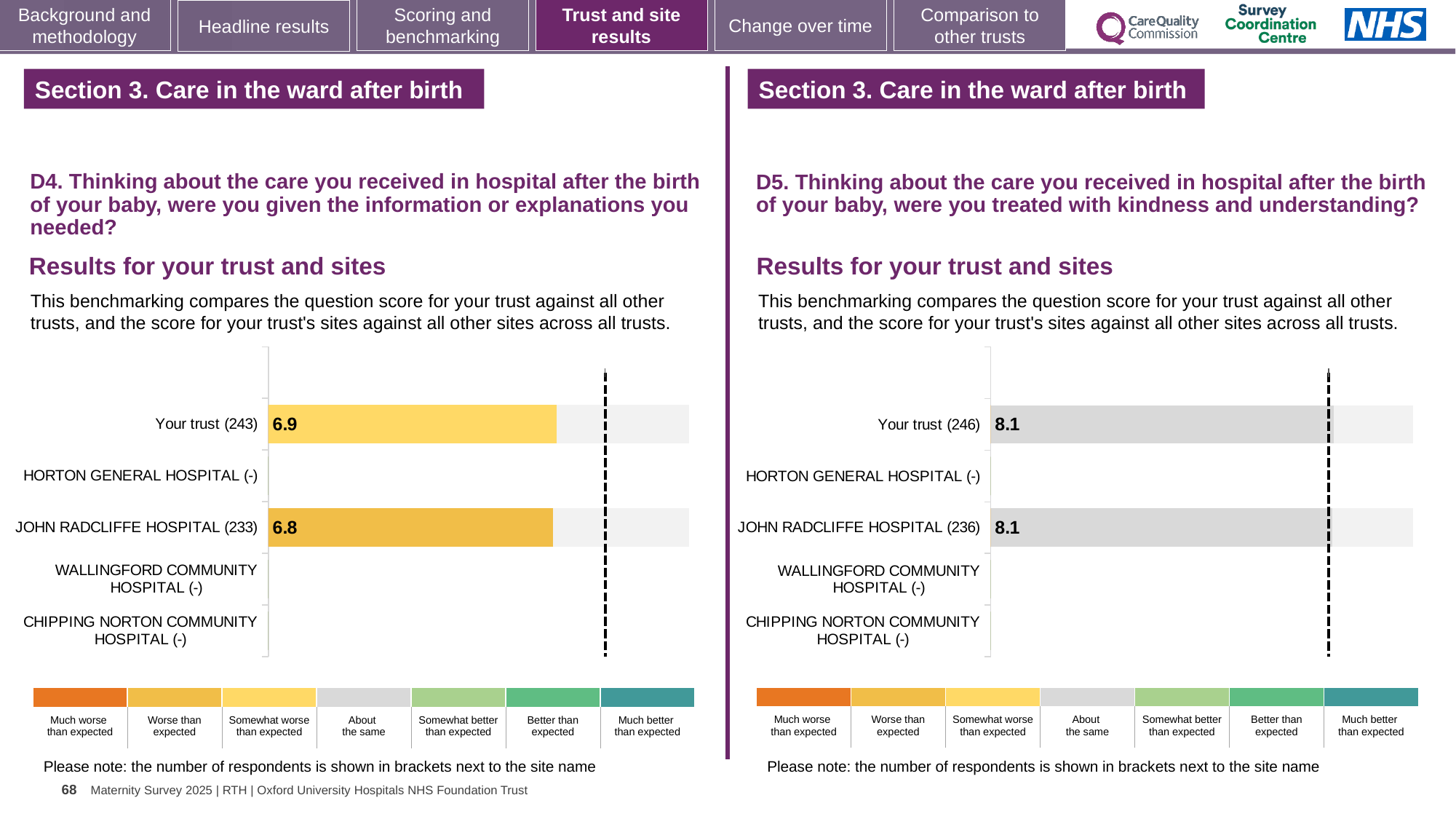
In the D5 chart on the right, what is the score for JOHN RADCLIFFE HOSPITAL? 8.1 In the D5 chart on the right, how many respondents are shown in brackets for JOHN RADCLIFFE HOSPITAL? 236 In the D5 chart on the right, what is the difference between the score for Your trust and the score for JOHN RADCLIFFE HOSPITAL? 0 In the D4 chart on the left, which benchmark category does the colour of the JOHN RADCLIFFE HOSPITAL bar correspond to in the legend? Worse than expected What kind of chart is the D5 chart on the right? Bar chart In the D5 chart on the right, what is the score for Your trust? 8.1 In the D4 chart on the left, what is the score for Your trust? 6.9 How many site or trust categories are listed on the y axis of the D4 chart on the left? 5 In the D5 chart on the right, which benchmark category does the colour of the Your trust bar correspond to in the legend? About the same In the D4 chart on the left, what is the score for JOHN RADCLIFFE HOSPITAL? 6.8 In the D4 chart on the left, how many respondents are shown in brackets for Your trust? 243 In the D4 chart on the left, what is the difference between the score for Your trust and the score for JOHN RADCLIFFE HOSPITAL? 0.1